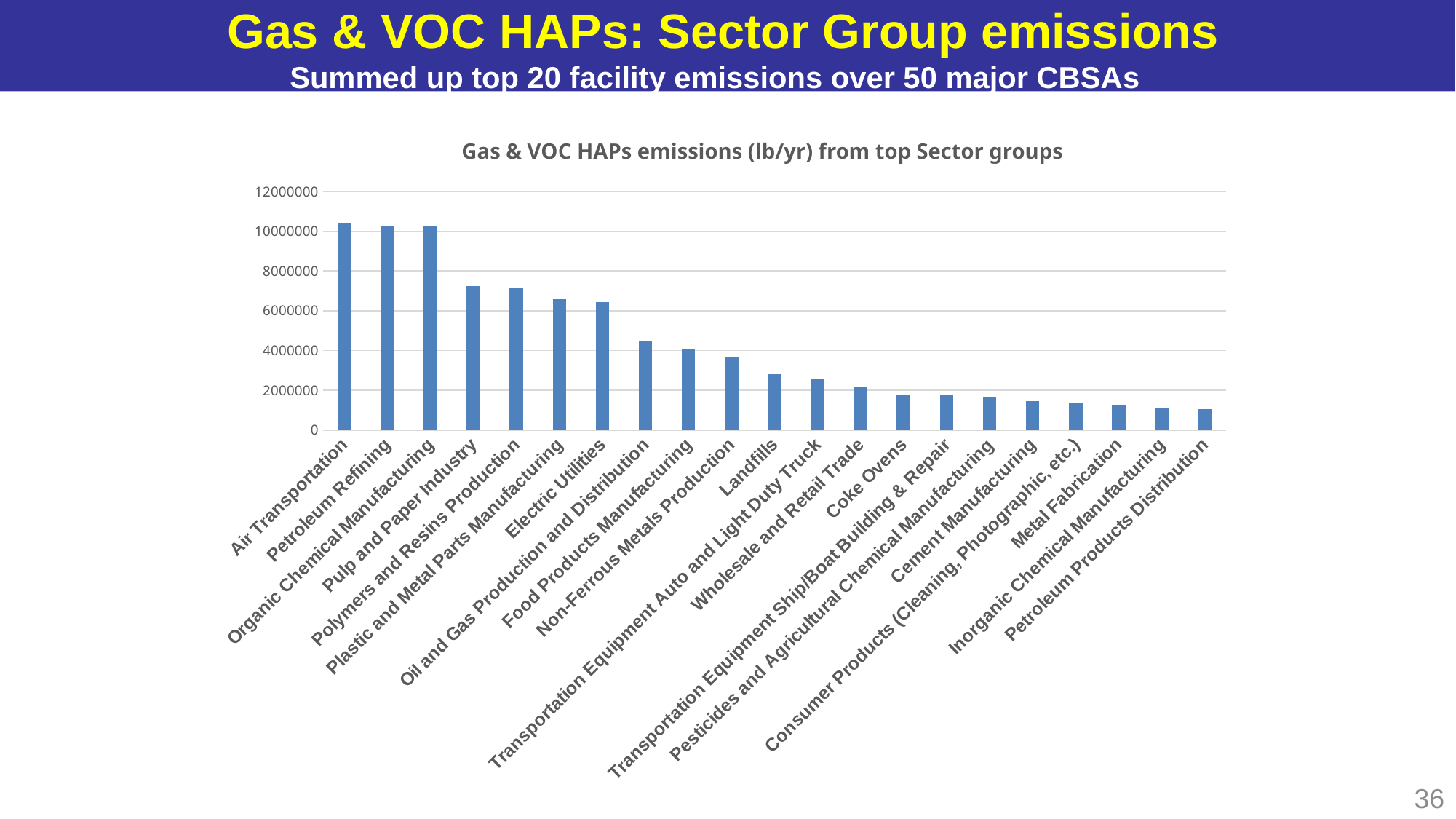
Is the value for Electric Utilities greater or less than 6000000? greater Which has higher emissions, Pulp and Paper Industry or Landfills? Pulp and Paper Industry Is the value for Landfills greater or less than 2000000? greater What kind of chart is shown on the slide? bar chart Is the value for Coke Ovens greater or less than 2000000? less Which sector group has the highest Gas & VOC HAPs emissions? Air Transportation How many sector groups are plotted in the chart? 21 Do the bar values rise or fall moving from left to right along the x axis? fall What is the title of the chart? Gas & VOC HAPs emissions (lb/yr) from top Sector groups